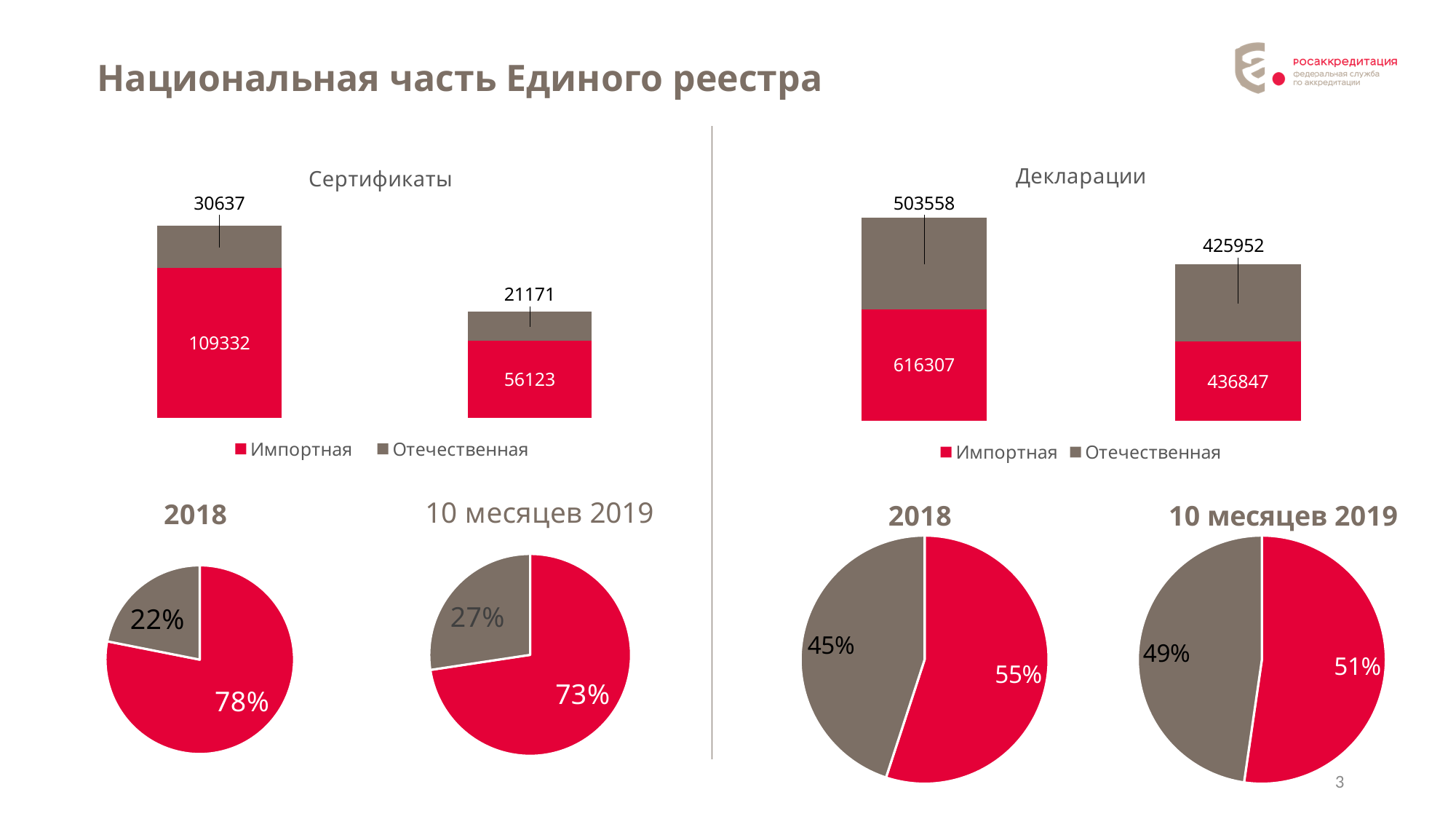
How many series does the legend of the 'Сертификаты' bar chart list? 2 In the 'Сертификаты' bar chart, what is the value of Импортная for 2018? 109332 In the 'Декларации' bar chart, what is the value of Импортная for 10 месяцев 2019? 436847 In the 'Сертификаты' bar chart, what is the total of the stacked bar for 2018? 139969 In the 'Декларации' bar chart, what is the value of Отечественная for 2018? 503558 In the 'Декларации' bar chart, what is the total of the stacked bar for 10 месяцев 2019? 862799 In the 'Сертификаты' bar chart, what is the value of Отечественная for 10 месяцев 2019? 21171 In the 'Сертификаты' bar chart, what is the difference between the Импортная values for 2018 and 10 месяцев 2019? 53209 In the 'Декларации' 10 месяцев 2019 pie chart, what share does the Отечественная (grey) slice have? 49% In the 'Декларации' bar chart, which is larger for 2018: Импортная or Отечественная? Импортная In the 'Сертификаты' 2018 pie chart, what share does the Импортная (red) slice have? 78% What kind of chart is used under the 'Декларации' title at the top right of the slide? Stacked bar chart